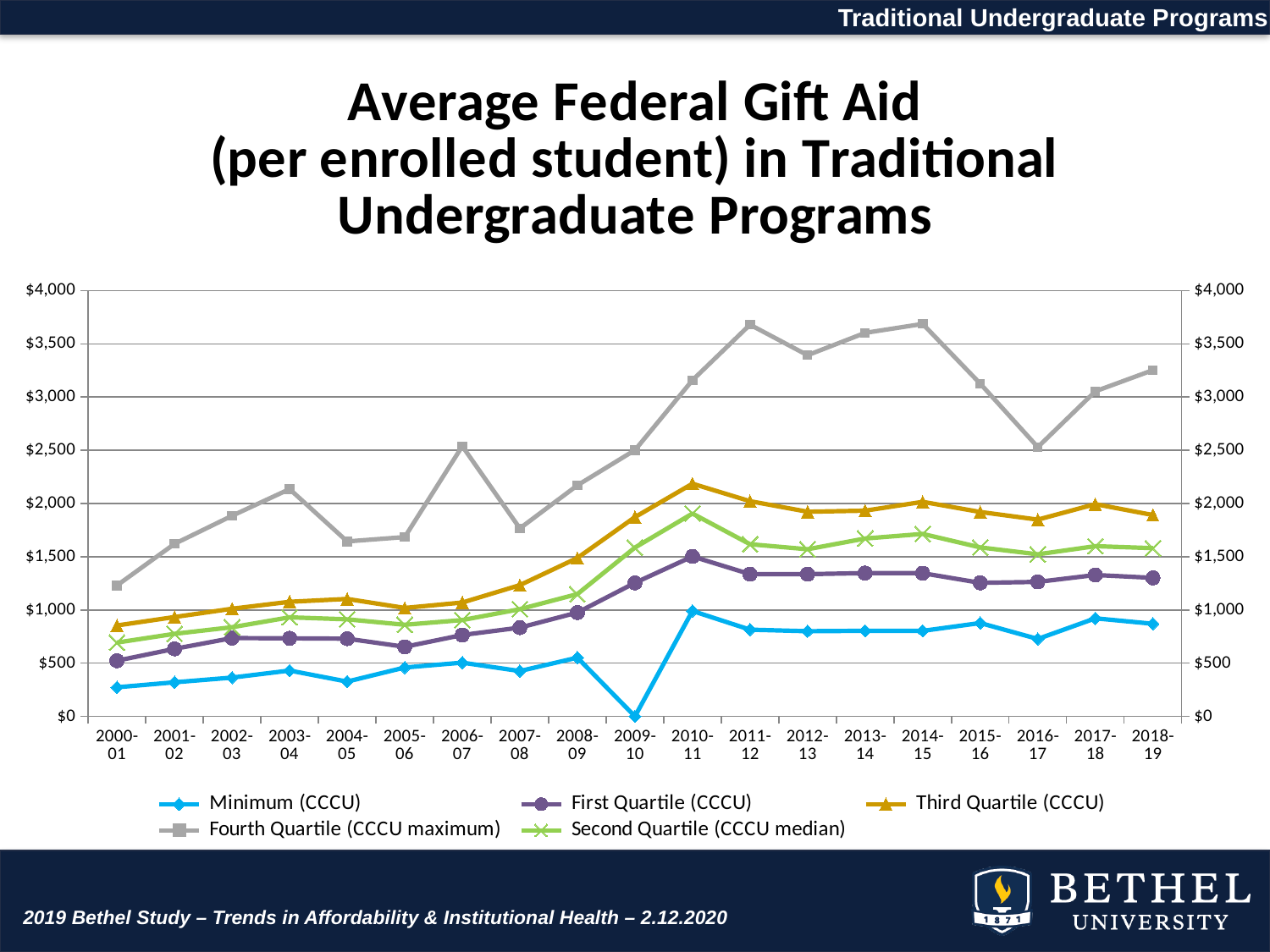
In which year is the Fourth Quartile (CCCU maximum) value lowest? 2000-01 Does the Fourth Quartile (CCCU maximum) value rise or fall from 2000-01 to 2003-04? rise Which legend entry is plotted with the gray line and square markers? Fourth Quartile (CCCU maximum) Is the Minimum (CCCU) value for 2009-10 greater or less than $500? less Is the Fourth Quartile (CCCU maximum) value for 2011-12 greater or less than $3,500? greater In which year is the Third Quartile (CCCU) value highest? 2010-11 How many academic years are plotted along the x axis? 19 What kind of chart is shown on the slide? line chart In which year is the Minimum (CCCU) value lowest? 2009-10 Which year has the larger Fourth Quartile (CCCU maximum) value, 2006-07 or 2007-08? 2006-07 Is the First Quartile (CCCU) value for 2000-01 greater or less than $1,000? less How many series does the legend list? 5